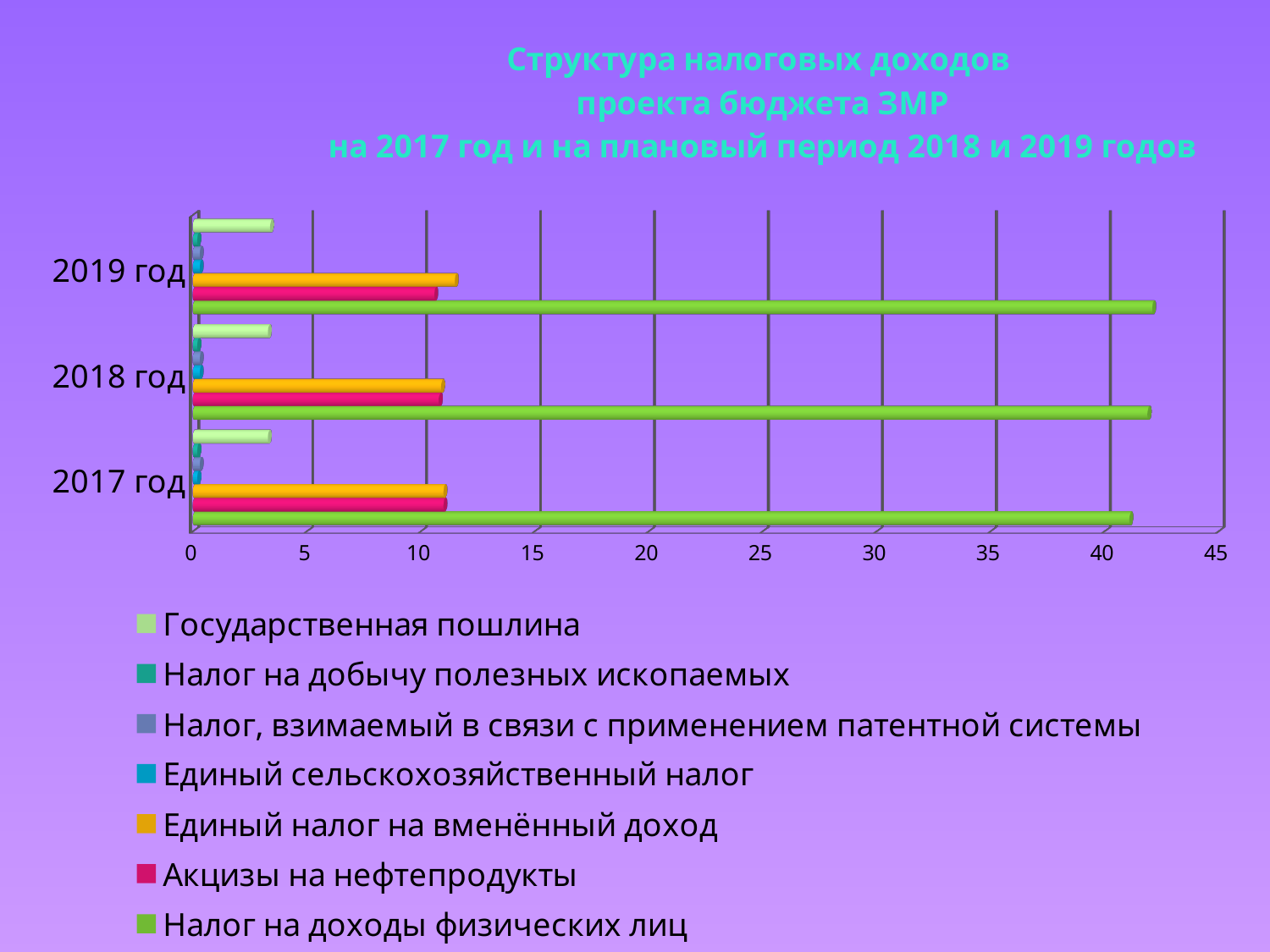
Is the value of Акцизы на нефтепродукты for 2017 год greater or less than 15? less Which series has the highest value for 2019 год? Налог на доходы физических лиц For 2018 год, which is larger: Налог на доходы физических лиц or Акцизы на нефтепродукты? Налог на доходы физических лиц Is the value of Государственная пошлина for 2019 год greater or less than 5? less What is the highest value shown on the horizontal axis of the chart? 45 For 2017 год, which is larger: Государственная пошлина or Единый налог на вменённый доход? Единый налог на вменённый доход Is the value of Налог на доходы физических лиц for 2018 год greater or less than 35? greater How many series does the chart legend list? 7 What kind of chart is shown on the slide? Bar chart Which series has the highest value for 2017 год? Налог на доходы физических лиц How many years (categories) are shown on the vertical axis of the chart? 3